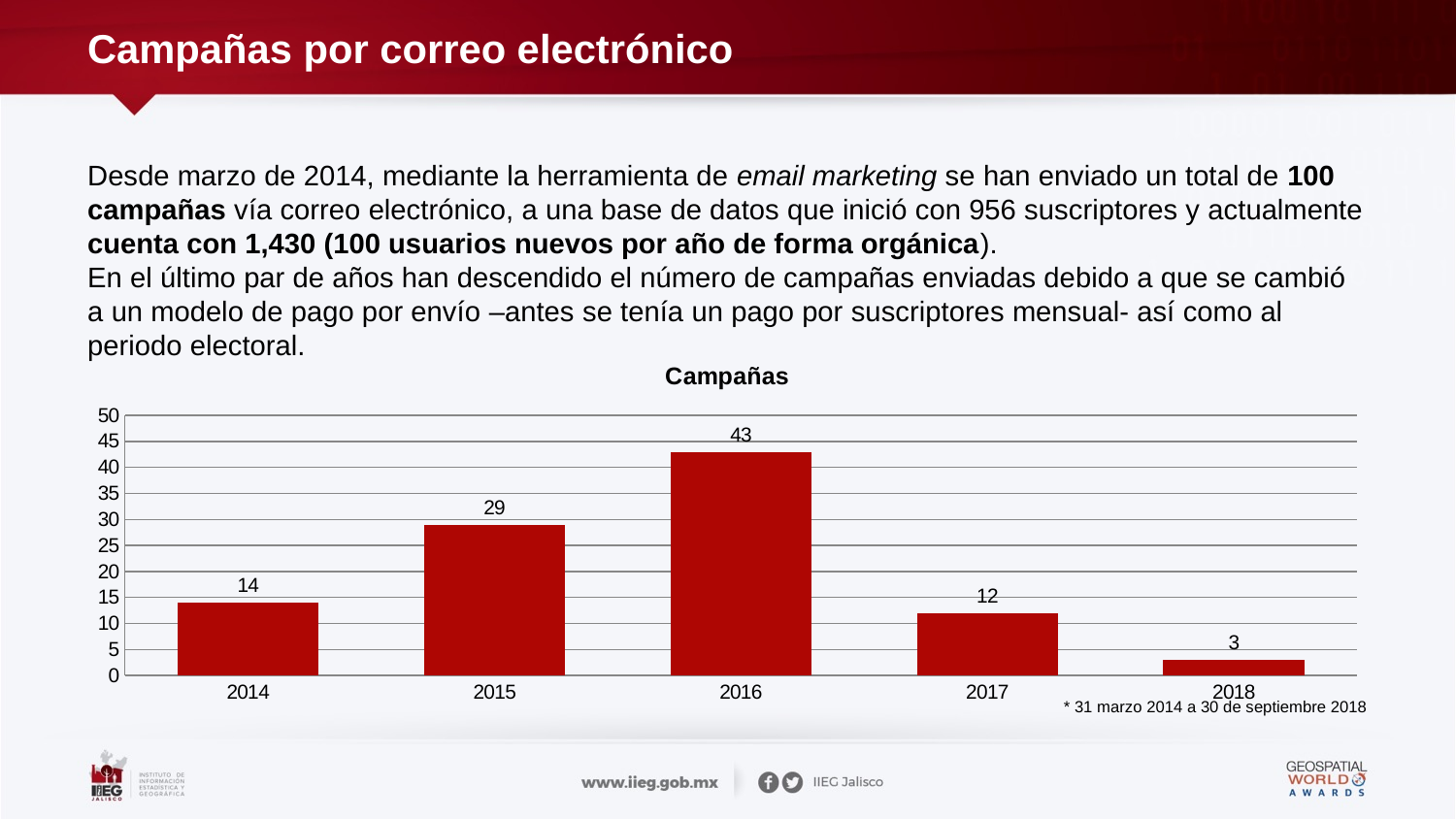
What is the value for 2018 in the Campañas chart? 3 What is the value for 2016 in the Campañas chart? 43 Which year has the lowest value in the Campañas chart? 2018 What is the difference between the values for 2017 and 2018 in the Campañas chart? 9 What is the value for 2014 in the Campañas chart? 14 Is the value for 2015 in the Campañas chart greater or less than 25? greater What is the difference between the values for 2016 and 2015 in the Campañas chart? 14 Which is larger in the Campañas chart, the value for 2015 or the value for 2017? 2015 How many years are shown on the x axis of the Campañas chart? 5 What is the title of the chart on the slide? Campañas Which year has the highest value in the Campañas chart? 2016 What kind of chart is the Campañas chart? bar chart